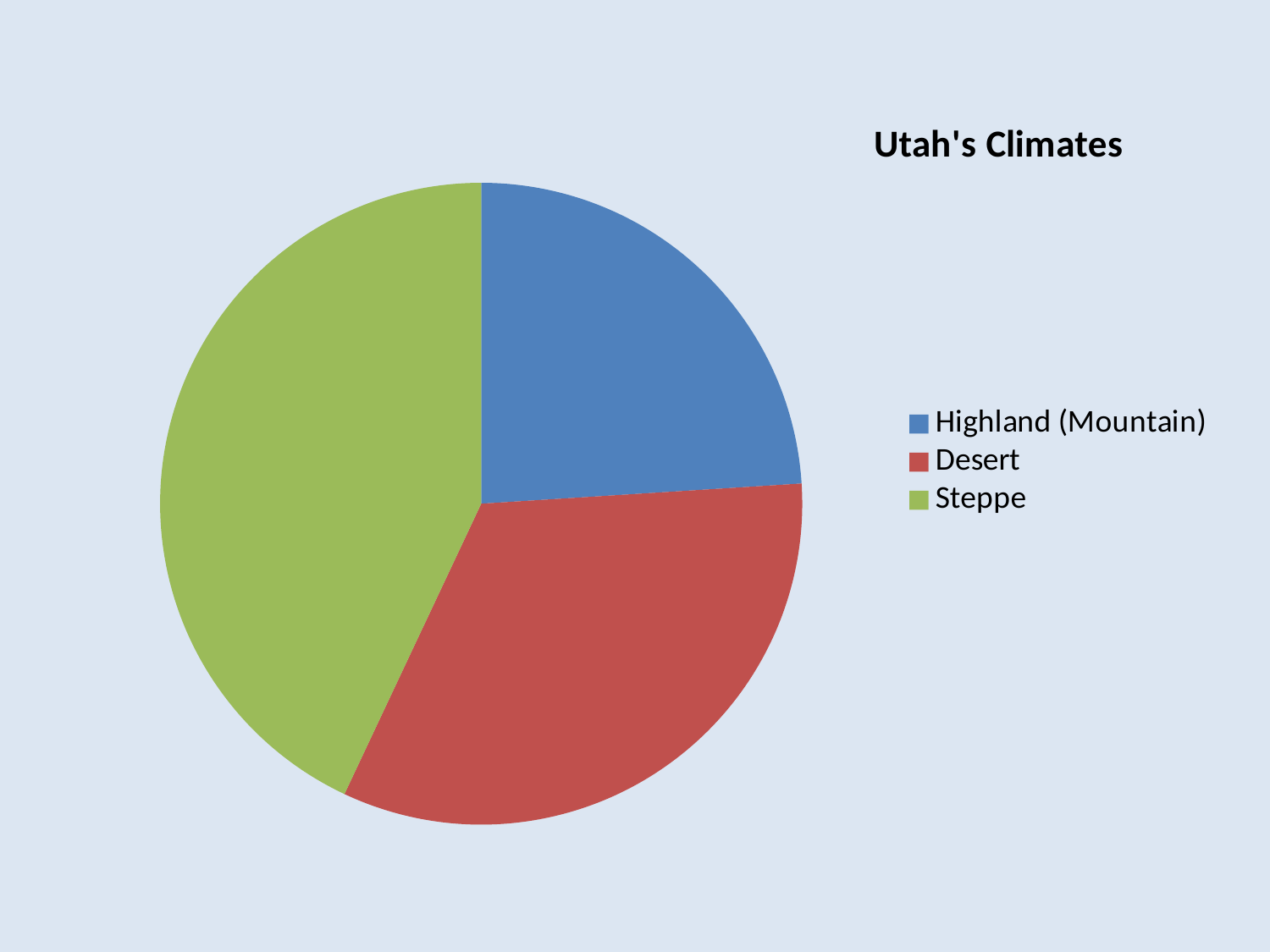
What is the title of the chart? Utah's Climates How many entries does the legend list? 3 What kind of chart is shown on the slide? Pie chart Which climate has the smallest slice of the pie? Highland (Mountain) How many slices does the pie chart have? 3 Which climate has the largest slice of the pie? Steppe What colour represents Desert in the pie chart? Red Which slice is larger, Steppe or Desert? Steppe Which slice is larger, Steppe or Highland (Mountain)? Steppe